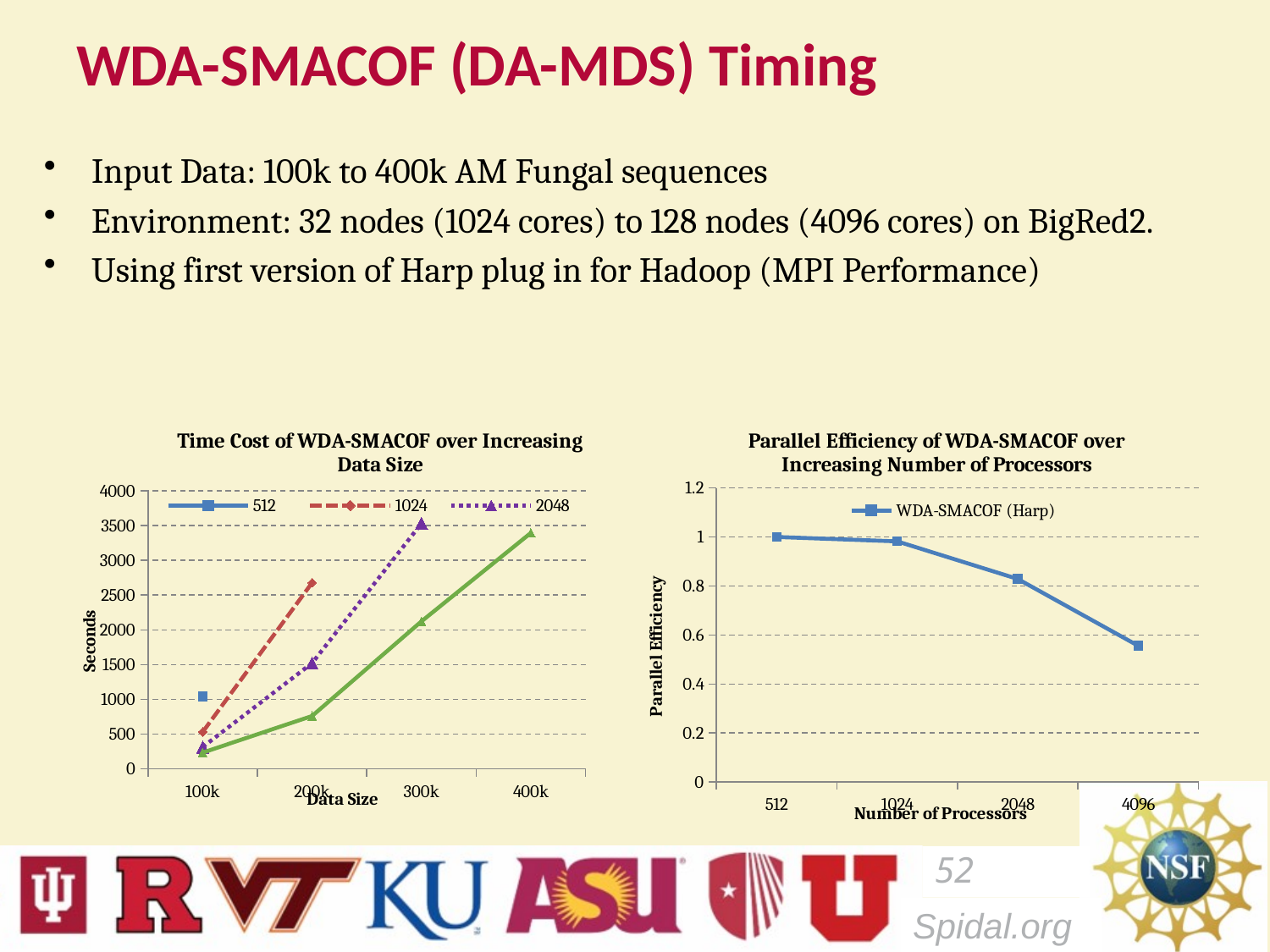
In the 'Time Cost of WDA-SMACOF over Increasing Data Size' chart, at 200k, which series has the higher time cost: 1024 or 2048? 1024 In the 'Time Cost of WDA-SMACOF over Increasing Data Size' chart, how many series does the legend list? 3 In the 'Parallel Efficiency of WDA-SMACOF over Increasing Number of Processors' chart, how many processor counts are plotted on the x axis? 4 In the 'Time Cost of WDA-SMACOF over Increasing Data Size' chart, is the value for the 2048 series at 300k greater or less than 3000? greater In the 'Time Cost of WDA-SMACOF over Increasing Data Size' chart, is the value for the 1024 series at 200k greater or less than 2500? greater What kind of chart is the 'Parallel Efficiency of WDA-SMACOF over Increasing Number of Processors' chart? line chart What kind of chart is the 'Time Cost of WDA-SMACOF over Increasing Data Size' chart? line chart What is the y-axis title of the 'Time Cost of WDA-SMACOF over Increasing Data Size' chart? Seconds In the 'Time Cost of WDA-SMACOF over Increasing Data Size' chart, does the time cost rise or fall as data size increases? rise In the 'Parallel Efficiency of WDA-SMACOF over Increasing Number of Processors' chart, does parallel efficiency rise or fall as the number of processors increases? fall In the 'Parallel Efficiency of WDA-SMACOF over Increasing Number of Processors' chart, which number of processors has the lowest parallel efficiency? 4096 In the 'Parallel Efficiency of WDA-SMACOF over Increasing Number of Processors' chart, is the value for 4096 processors greater or less than 0.6? less